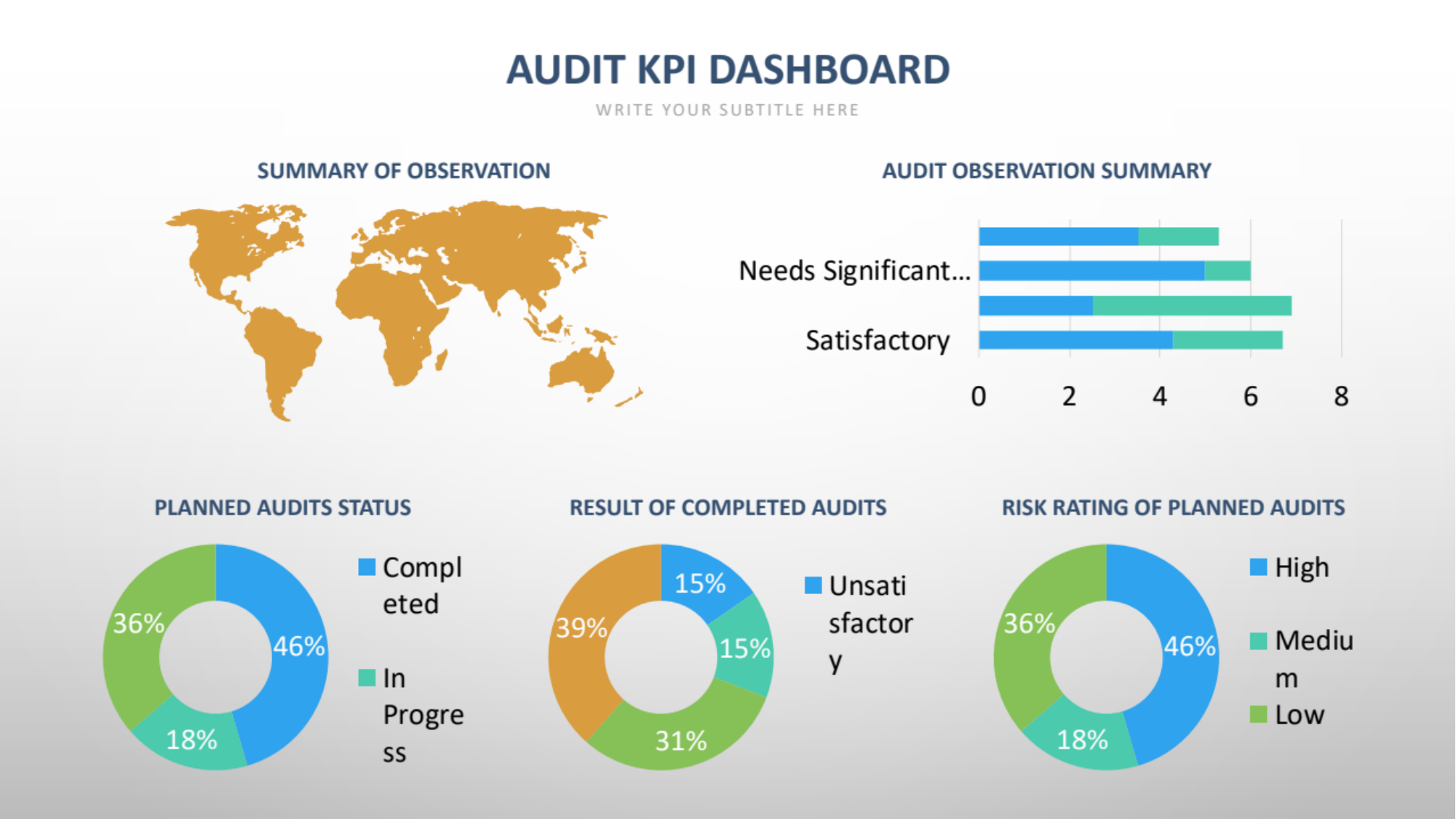
In the Risk Rating of Planned Audits chart, which category has the smallest share? Medium In the Risk Rating of Planned Audits chart, which category has the largest share? High In the Planned Audits Status chart, what percentage is Completed? 46% In the Risk Rating of Planned Audits chart, what percentage is Medium? 18% In the Risk Rating of Planned Audits chart, what percentage is High? 46% In the Planned Audits Status chart, which is larger, Completed or In Progress? Completed In the Planned Audits Status chart, what percentage is In Progress? 18% How many slices does the Result of Completed Audits chart have? 4 In the Risk Rating of Planned Audits chart, what is the difference between the High and Low percentages? 10% What kind of chart is the Audit Observation Summary chart? Stacked bar chart In the Result of Completed Audits chart, what percentage is Unsatisfactory? 15% In the Audit Observation Summary chart, is the total length of the Satisfactory bar greater or less than 6? greater